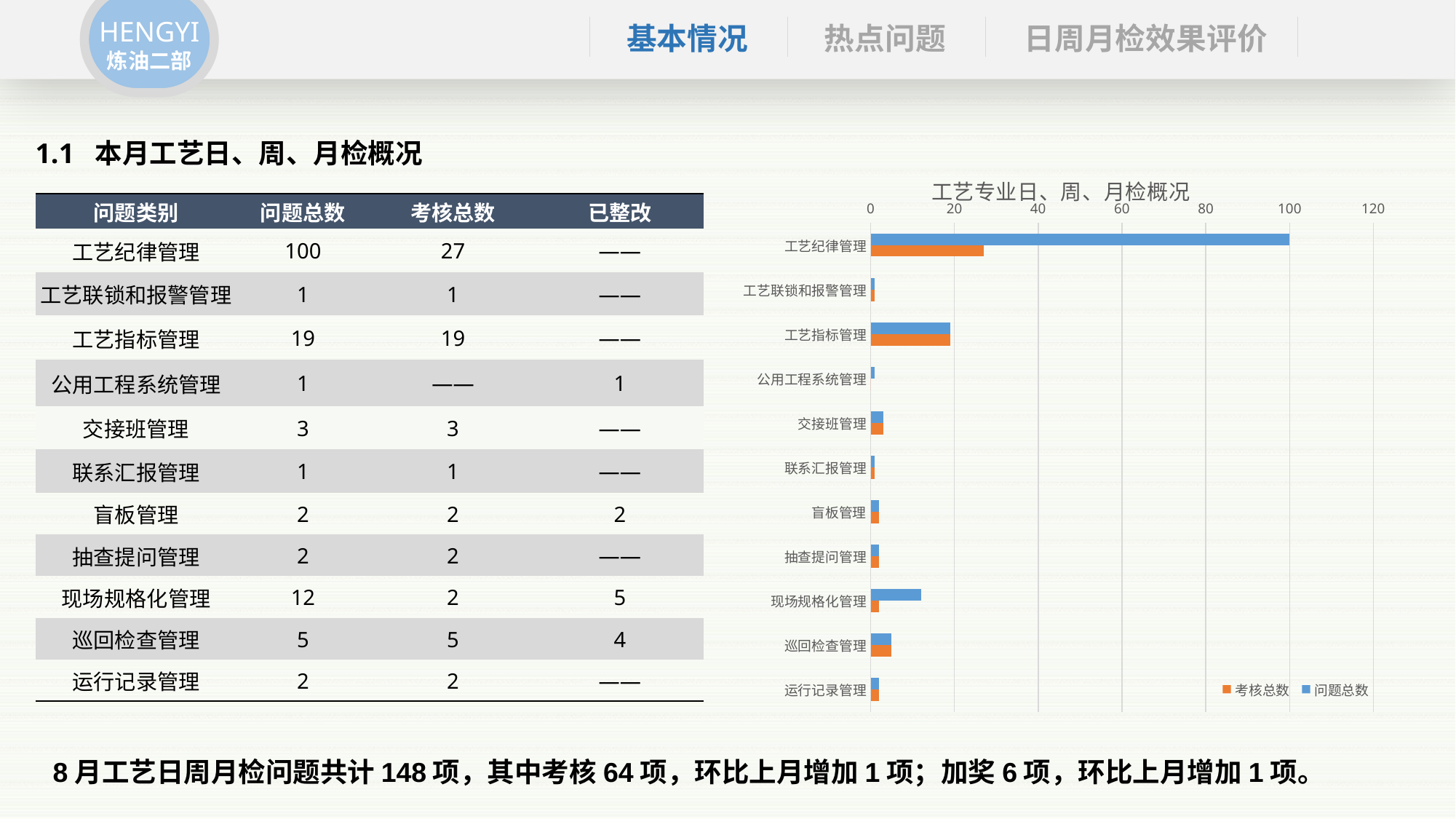
What kind of chart is shown on the slide? bar chart How many series does the chart legend list? 2 Which colour represents the 考核总数 series in the chart? orange What is the title of the chart? 工艺专业日、周、月检概况 Is the 问题总数 value for 现场规格化管理 greater or less than 20? less Which category has the highest 考核总数 in the chart? 工艺纪律管理 How many categories are plotted on the chart? 11 Is the 考核总数 value for 工艺纪律管理 greater or less than 20? greater Which category has the highest 问题总数 in the chart? 工艺纪律管理 Is the 问题总数 value for 工艺纪律管理 greater or less than 80? greater For 现场规格化管理, which is larger, 问题总数 or 考核总数? 问题总数 Which is larger, the 问题总数 for 工艺纪律管理 or for 工艺指标管理? 工艺纪律管理